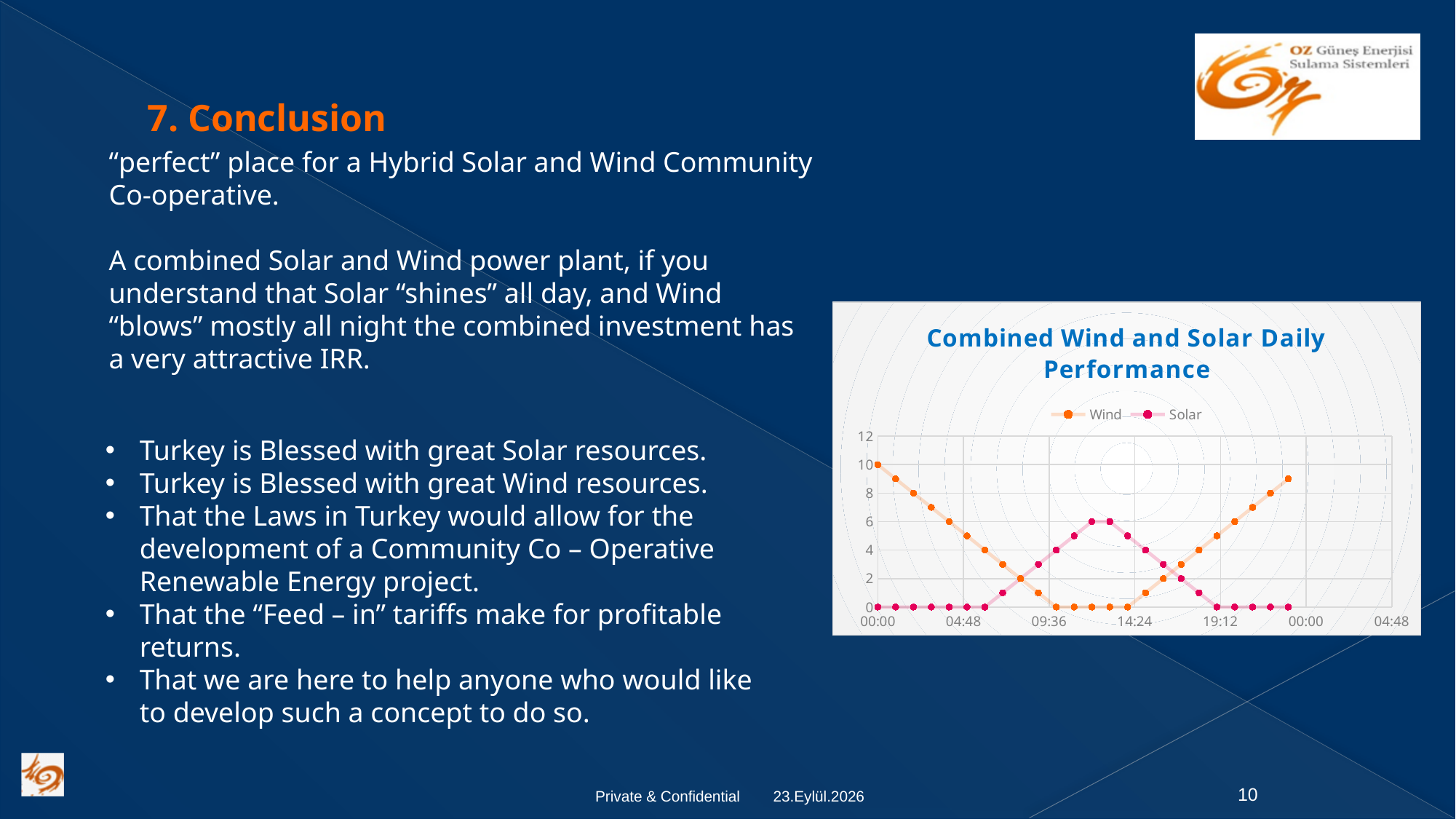
What is the Solar value at the first 00:00 on the x axis? 0 What are the two series named in the chart legend? Wind and Solar What is the title of the chart? Combined Wind and Solar Daily Performance What kind of chart is shown on the slide? line chart Which series reaches a higher peak value, Wind or Solar? Wind What is the peak value reached by the Solar series? 6 How many series does the legend of the chart list? 2 Does the Wind series rise or fall between 00:00 and 09:36? fall Is the Wind value at 04:48 greater or less than 8? less What is the Wind value at the first 00:00 on the x axis? 10 Is the Wind value at 14:24 greater or less than 2? less Is the Solar value at 09:36 greater or less than 2? greater